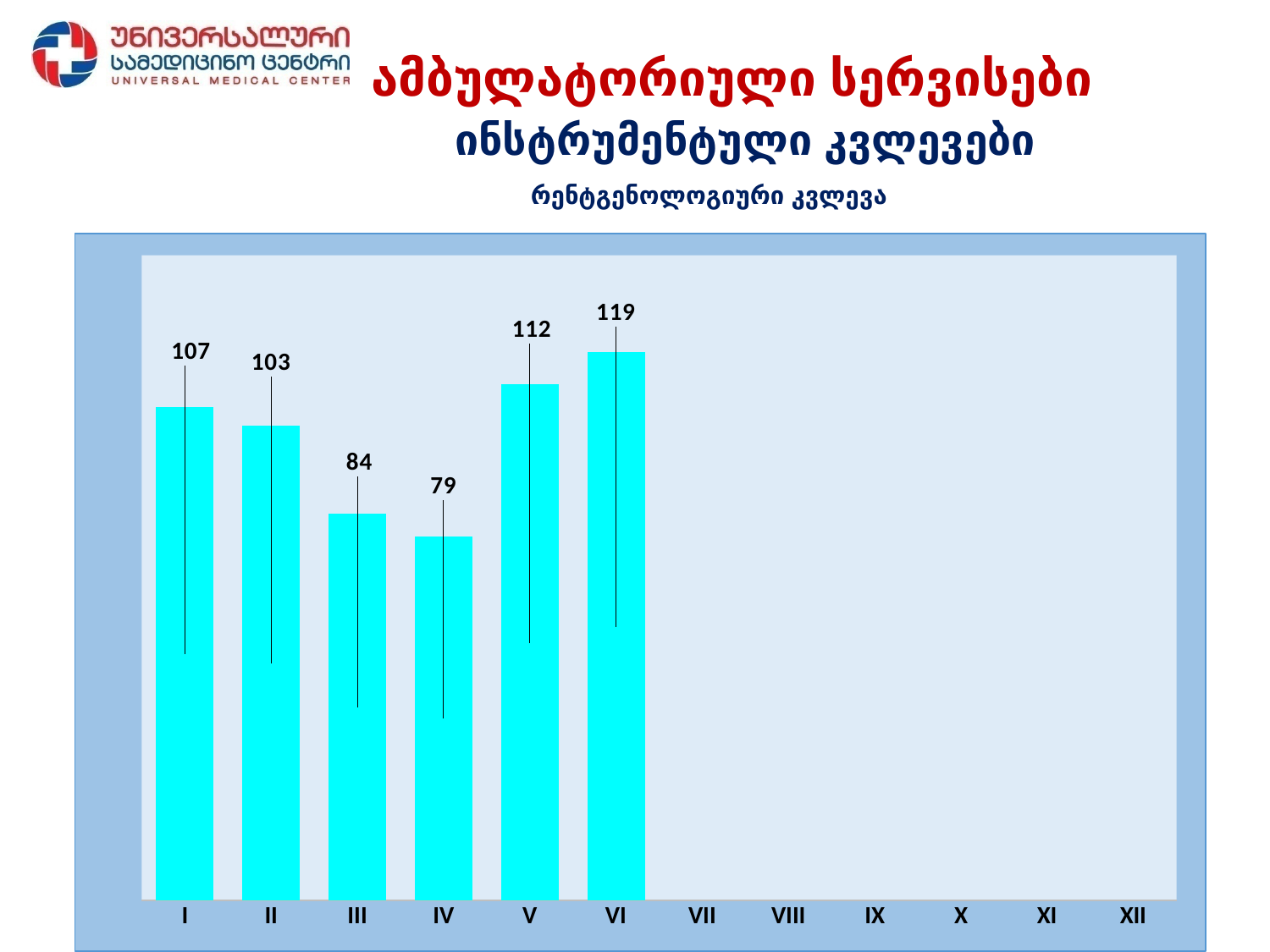
Which month has the lowest value among the plotted bars? IV Which is larger, the value for month III or the value for month V? V What is the value for month I? 107 What is the value for month IV? 79 Do the values rise or fall from month II to month IV? fall What is the difference between the values for month I and month II? 4 How many category labels are shown on the x axis? 12 Which month has the highest value? VI What kind of chart is shown on the slide? bar chart What is the value for month VI? 119 What is the difference between the values for month VI and month IV? 40 How many months have a bar plotted on the chart? 6